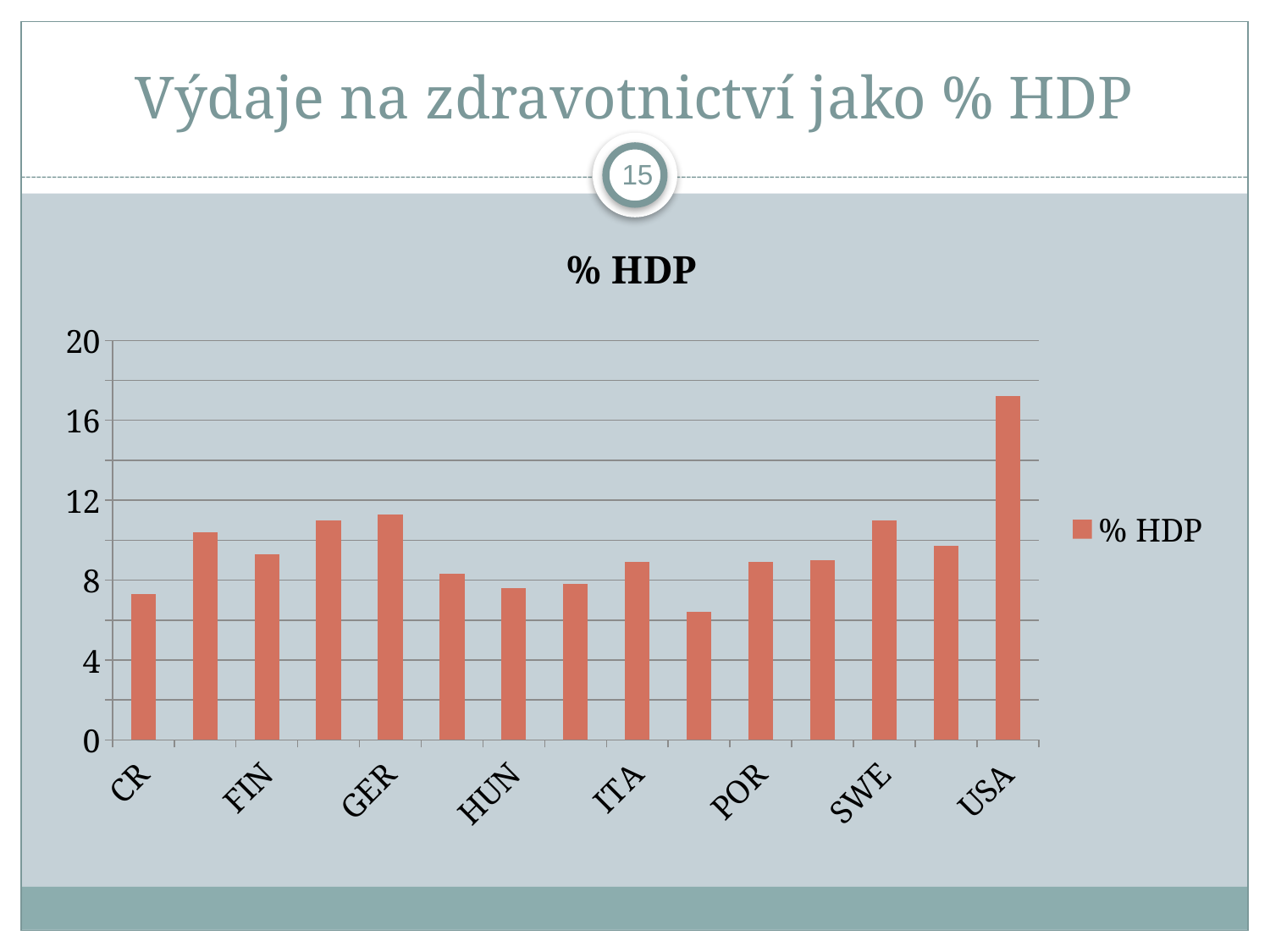
Is the value for GER greater or less than 12? less Is the value for CR greater or less than 8? less What kind of chart is shown on the slide? bar chart Which is larger, the value for GER or the value for CR? GER Which country has the highest value in the % HDP chart? USA Is the value for SWE greater or less than 8? greater Which is larger, the value for USA or the value for SWE? USA What is the title of the chart? % HDP How many bars are plotted in the chart? 15 How many series does the legend list? 1